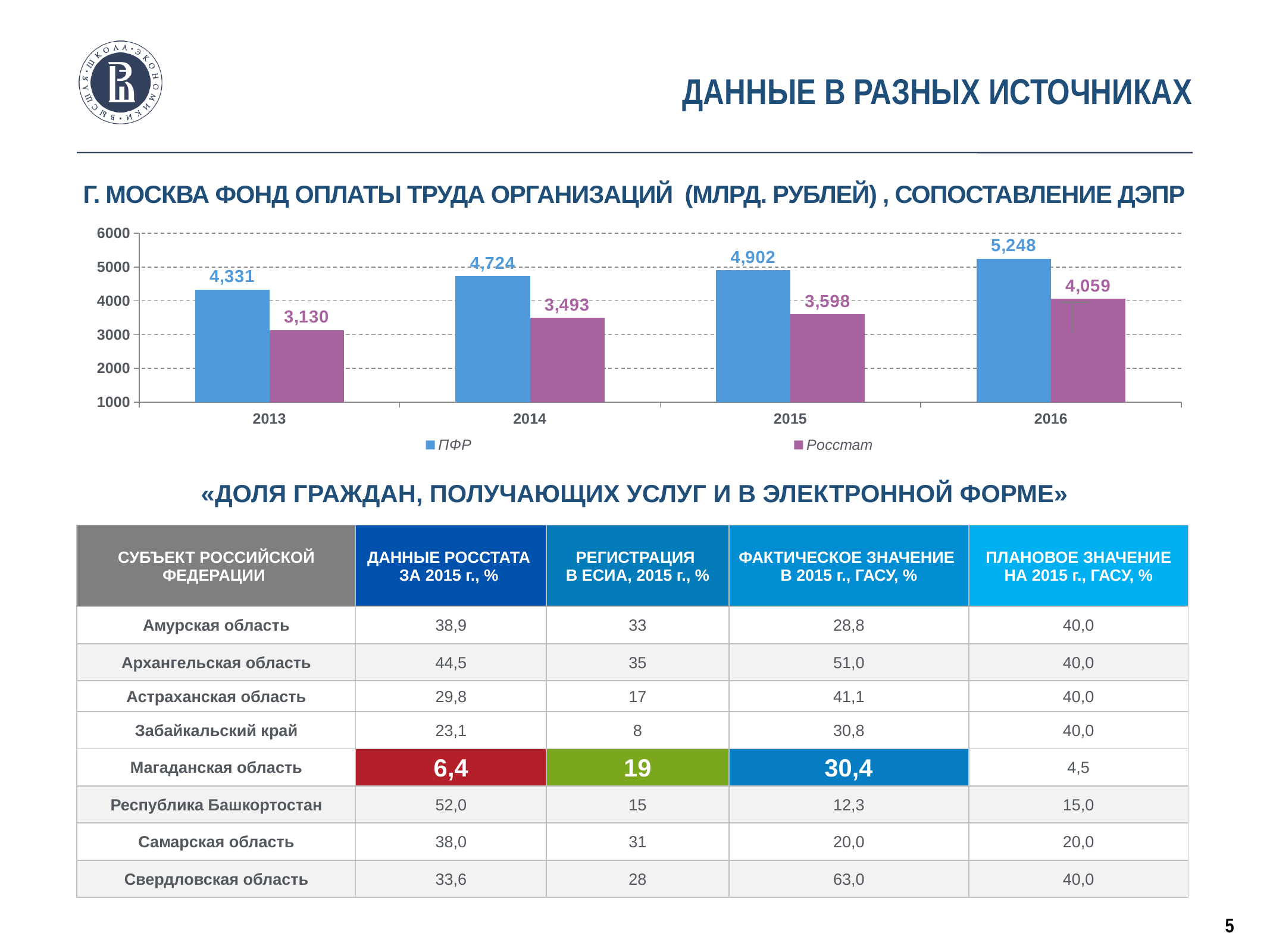
Which year has the lowest Росстат value in the chart? 2013 Which year has the highest ПФР value in the chart? 2016 What is the difference between the ПФР and Росстат values for 2016? 1,189 How many years are shown on the x axis of the chart? 4 Is the Росстат value for 2016 greater or less than 4000? greater How many series does the chart legend list? 2 What kind of chart is shown on the slide? bar chart What is the Росстат value for 2016 in the chart? 4,059 What is the ПФР value for 2015 in the chart? 4,902 What is the difference between the ПФР and Росстат values for 2013? 1,201 Which is larger in 2015: the ПФР value or the Росстат value? ПФР What is the Росстат value for 2014 in the chart? 3,493